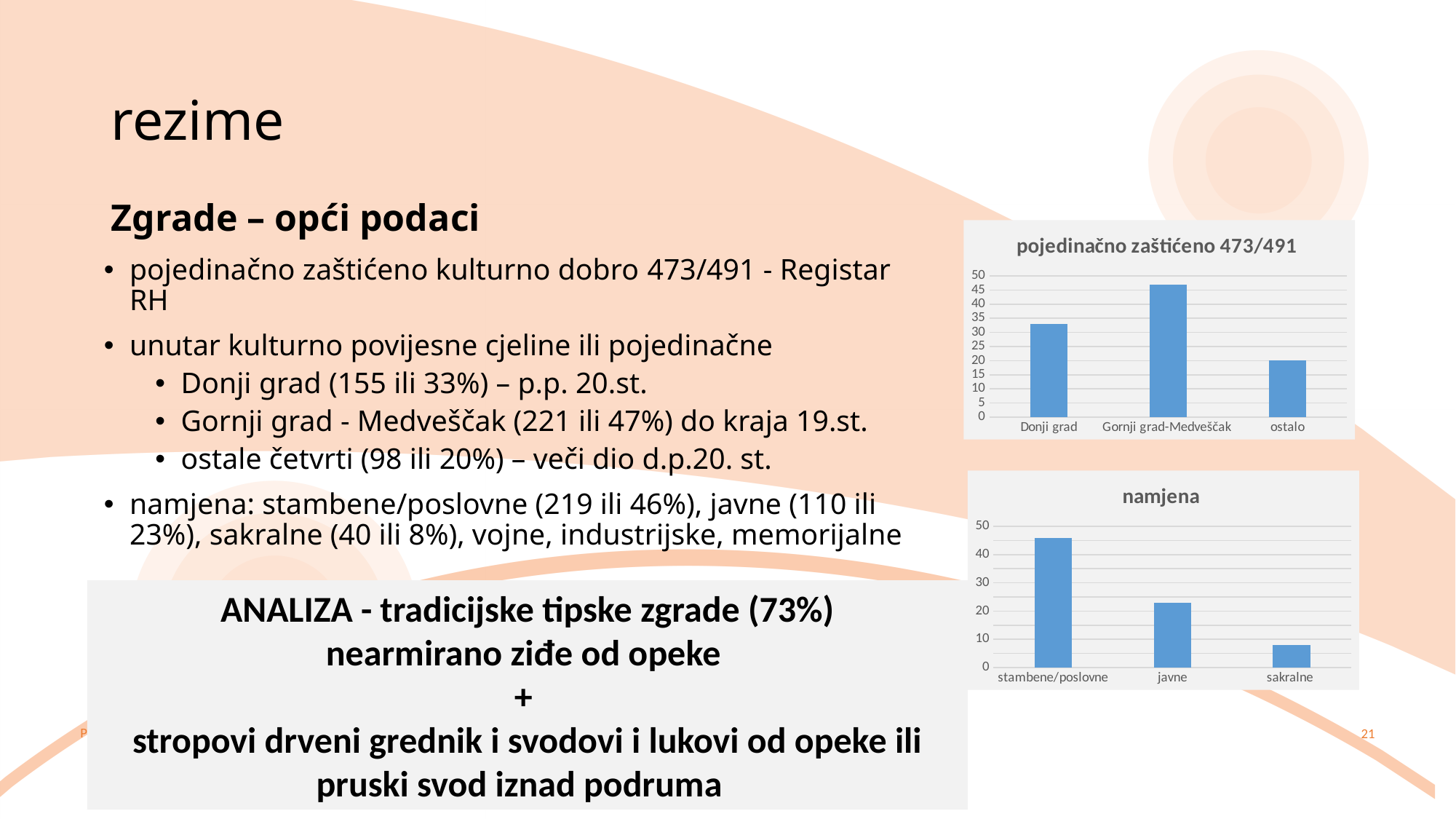
In the chart titled "namjena", is the value for sakralne greater or less than 10? less What kind of chart is the chart titled "namjena"? bar chart In the chart titled "pojedinačno zaštićeno 473/491", which is larger, the value for Donji grad or the value for ostalo? Donji grad In the chart titled "namjena", which category has the lowest bar? sakralne In the chart titled "pojedinačno zaštićeno 473/491", how many categories are shown on the x axis? 3 In the chart titled "pojedinačno zaštićeno 473/491", which category has the highest bar? Gornji grad-Medveščak In the chart titled "pojedinačno zaštićeno 473/491", is the value for Gornji grad-Medveščak greater or less than 45? greater In the chart titled "pojedinačno zaštićeno 473/491", is the value for Donji grad greater or less than 30? greater In the chart titled "pojedinačno zaštićeno 473/491", which category has the lowest bar? ostalo In the chart titled "namjena", which category has the highest bar? stambene/poslovne What is the title of the lower chart on the right side of the slide? namjena